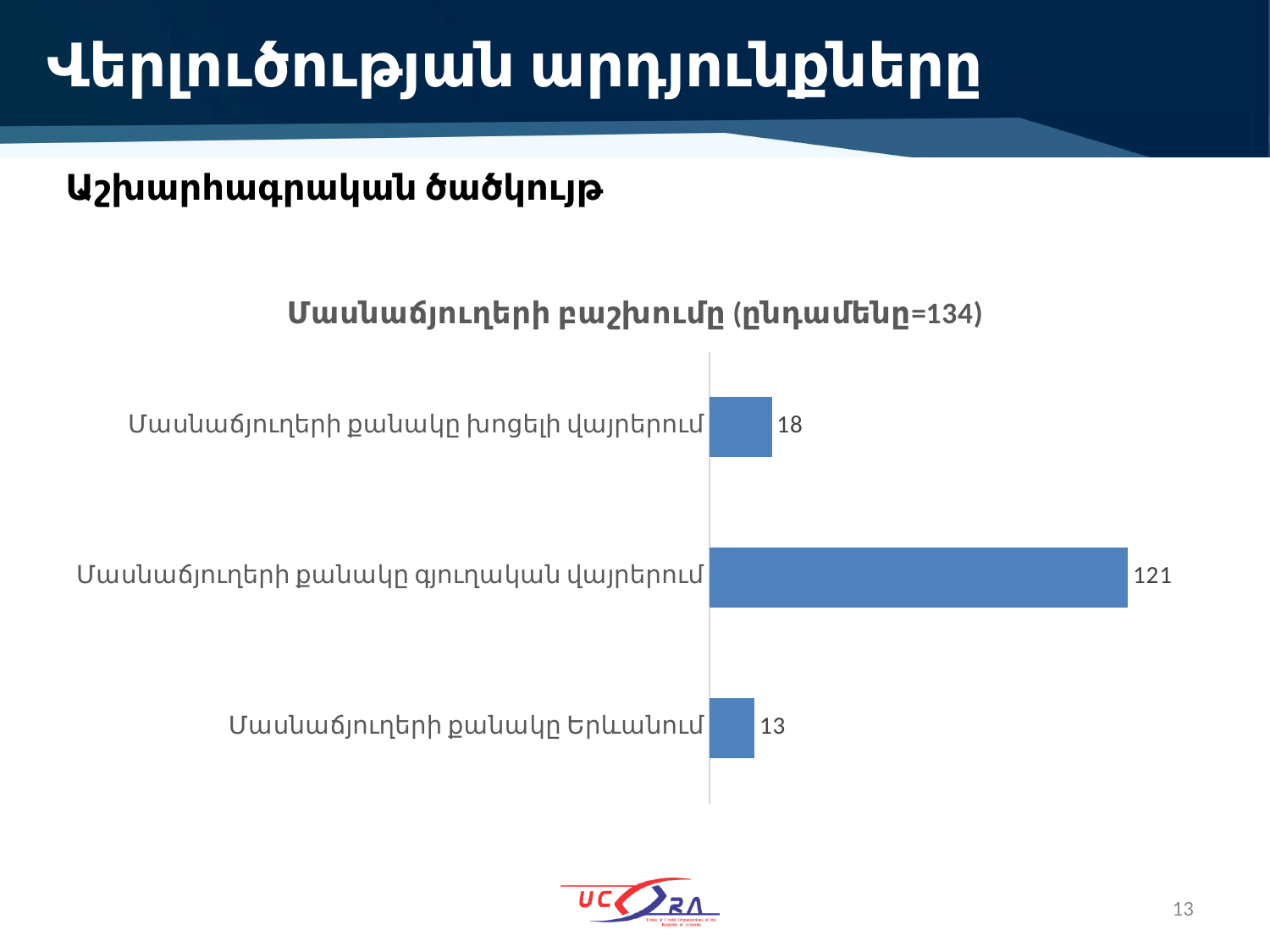
What is the difference between the value for "Մասնաճյուղերի քանակը գյուղական վայրերում" and the value for "Մասնաճյուղերի քանակը Երևանում"? 108 What is the difference between the value for "Մասնաճյուղերի քանակը խոշելի վայրերում" and the value for "Մասնաճյուղերի քանակը Երևանում"? 5 What type of chart is shown on the slide? bar chart Which category has the highest value? Մասնաճյուղերի քանակը գյուղական վայրերում What is the title of the chart? Մասնաճյուղերի բաշխումը (ընդամենը=134) How many categories (bars) does the chart show? 3 Which is larger: the value for "Մասնաճյուղերի քանակը խոշելի վայրերում" or the value for "Մասնաճյուղերի քանակը Երևանում"? Մասնաճյուղերի քանակը խոցելի վայրերում Which category has the lowest value? Մասնաճյուղերի քանակը Երևանում What is the value for "Մասնաճյուղերի քանակը Երևանում"? 13 What is the value for "Մասնաճյուղերի քանակը խոշելի վայրերում"? 18 What is the value for "Մասնաճյուղերի քանակը գյուղական վայրերում"? 121 What total is stated in the chart title? 134